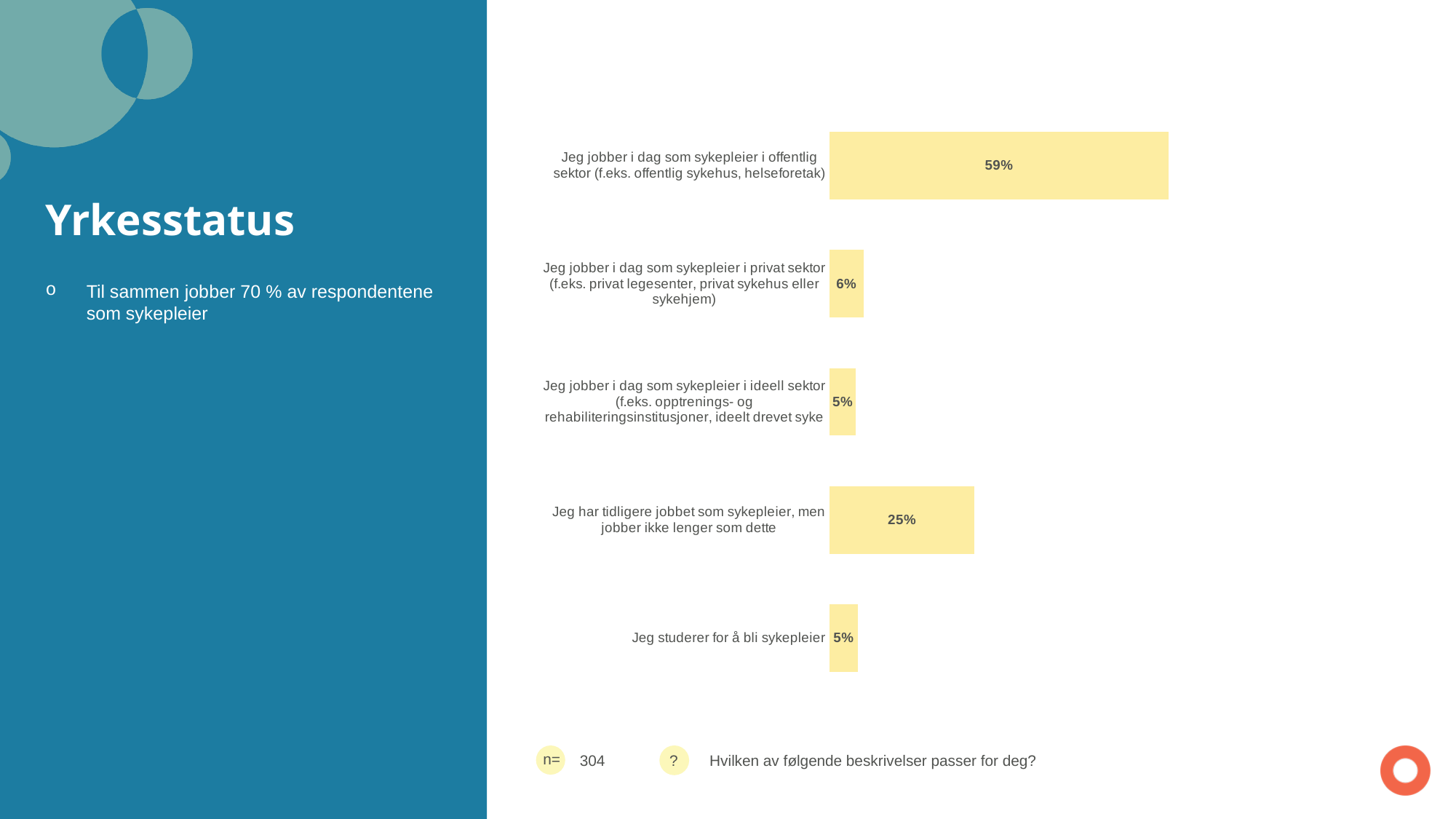
What is the value for 'Jeg studerer for å bli sykepleier'? 5% What kind of chart is shown on the slide? bar chart What is the title of the slide? Yrkesstatus Which is larger: the value for private sector (privat sektor) or the value for ideell sektor? privat sektor What percentage of respondents have previously worked as a nurse but no longer do so? 25% What is the total of the public sector, private sector and ideell sektor values combined? 70% What is the value for 'Jeg jobber i dag som sykepleier i privat sektor'? 6% What is the difference between the public sector (offentlig sektor) value and the 'tidligere jobbet som sykepleier' value? 34 percentage points What is the n (number of respondents) shown below the chart? 304 What percentage of respondents currently work as a nurse in the public sector (offentlig sektor)? 59% How many categories are shown in the chart? 5 Which category has the highest value? Jeg jobber i dag som sykepleier i offentlig sektor